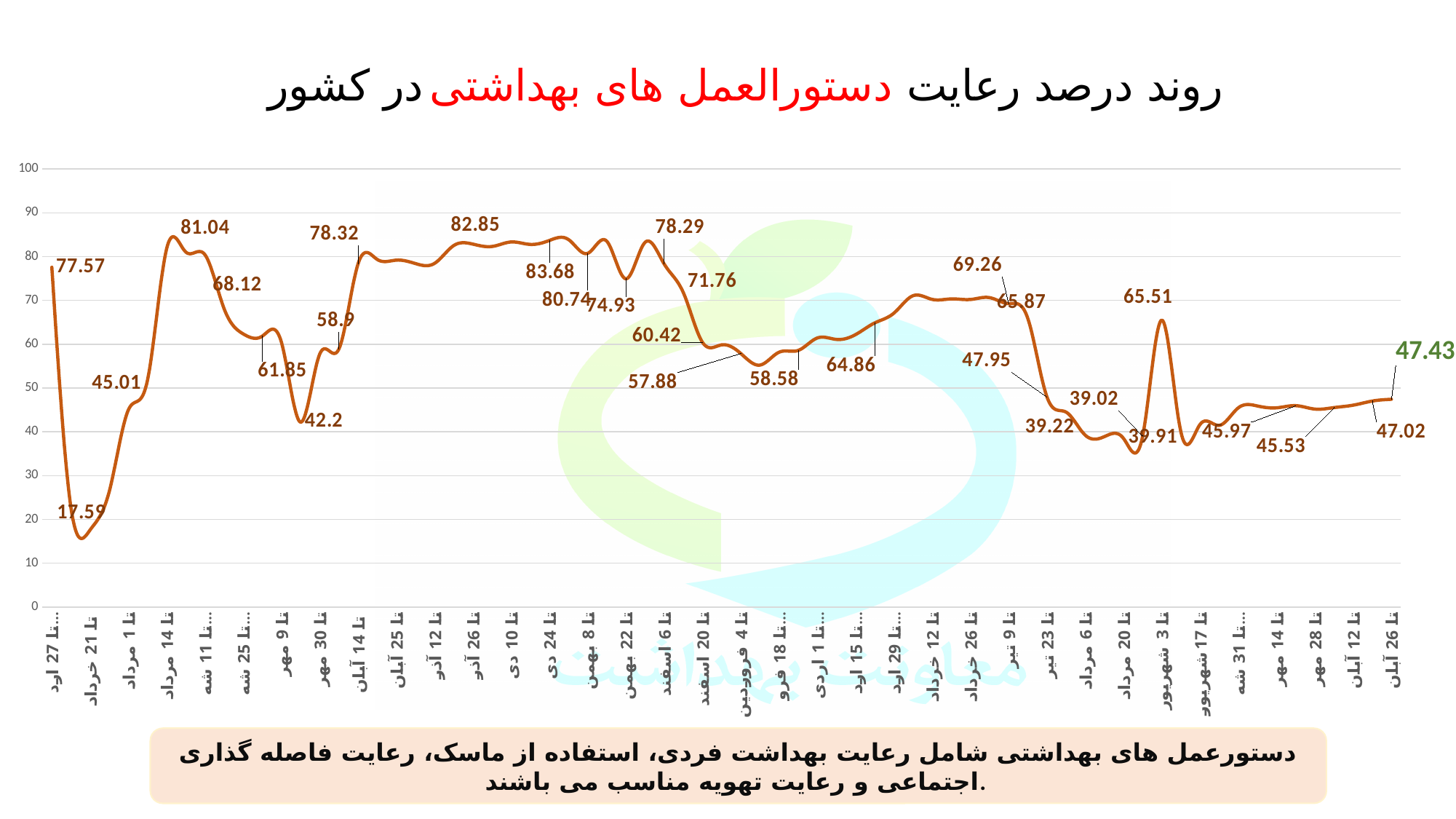
What is the value of the first data point on the line (تا 27 ارد)? 77.57 Is the value at تا 20 مرداد greater or less than 40? less What is the lowest value labelled on the line? 17.59 What kind of chart is shown on the slide? line chart Which is larger: the first value on the line (77.57) or the last value (47.43)? 77.57 What is the difference between the first labelled value (77.57) and the lowest labelled value (17.59)? 59.98 Is the value at تا 14 مرداد greater or less than 80? greater Does the line rise or fall between تا 27 ارد and تا 21 خرداد? fall What is the value labelled at the sharp dip near تا 9 مهر? 42.2 What is the value of the last data point, labelled in green at the right end of the line (تا 26 آبان)? 47.43 What is the maximum value shown on the vertical axis? 100 What is the value labelled at the spike near تا 3 شهریور? 65.51